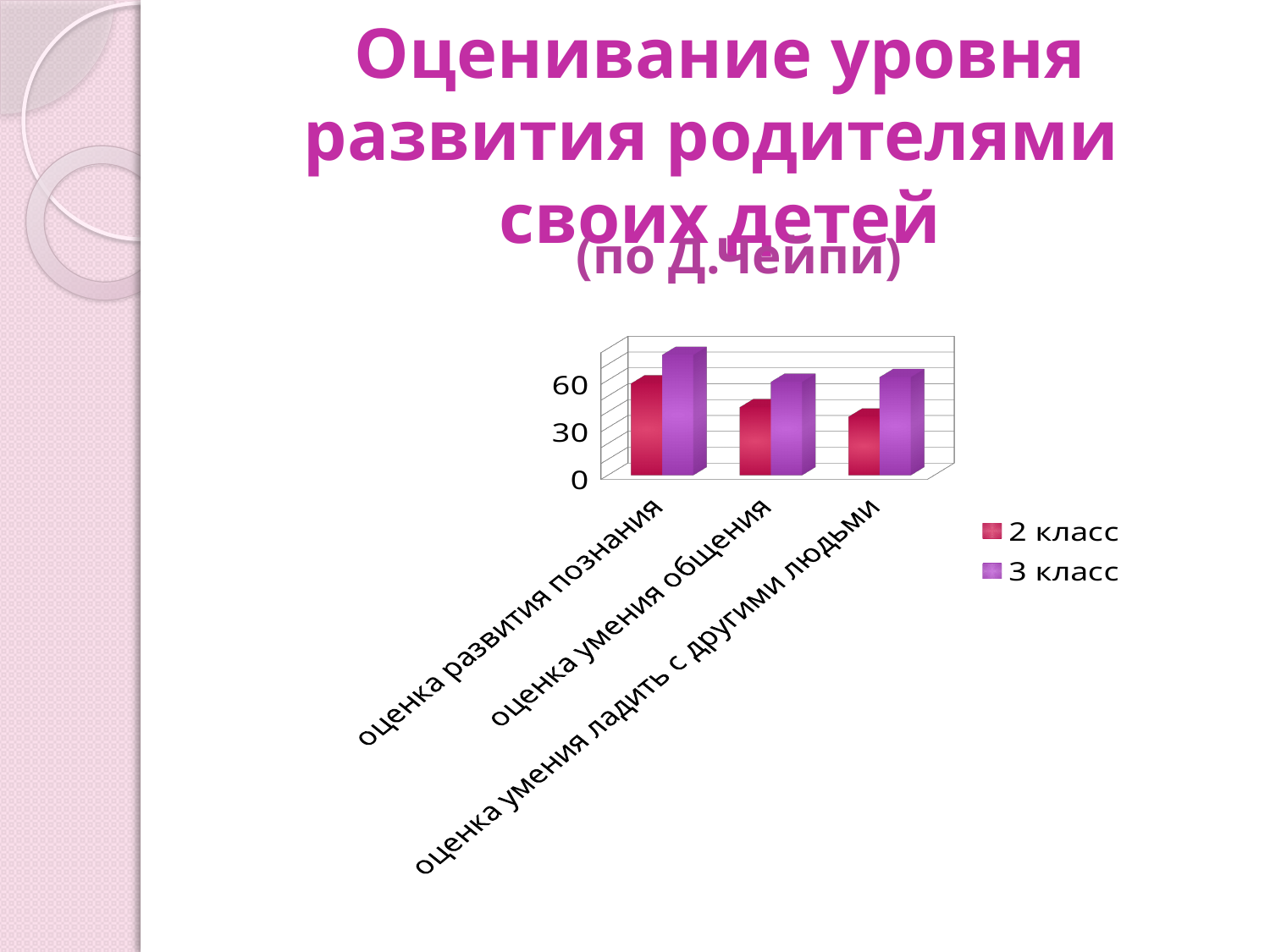
Do the values for the series "2 класс" rise or fall from left to right along the x axis? fall Is the value for "3 класс" in the category "оценка развития познания" greater or less than 60? greater How many series does the chart's legend list? 2 In the category "оценка умения общения", which series has the larger value, "2 класс" or "3 класс"? 3 класс What colour are the bars for the series "3 класс"? purple For the series "2 класс", which category has the highest value? оценка развития познания Is the value for "2 класс" in the category "оценка умения ладить с другими людьми" greater or less than 30? greater Which series are listed in the chart's legend? 2 класс, 3 класс How many categories are shown on the x axis of the chart? 3 For the series "3 класс", which category has the highest value? оценка развития познания Is the value for "2 класс" in the category "оценка умения общения" greater or less than 60? less What kind of chart is shown on the slide? bar chart